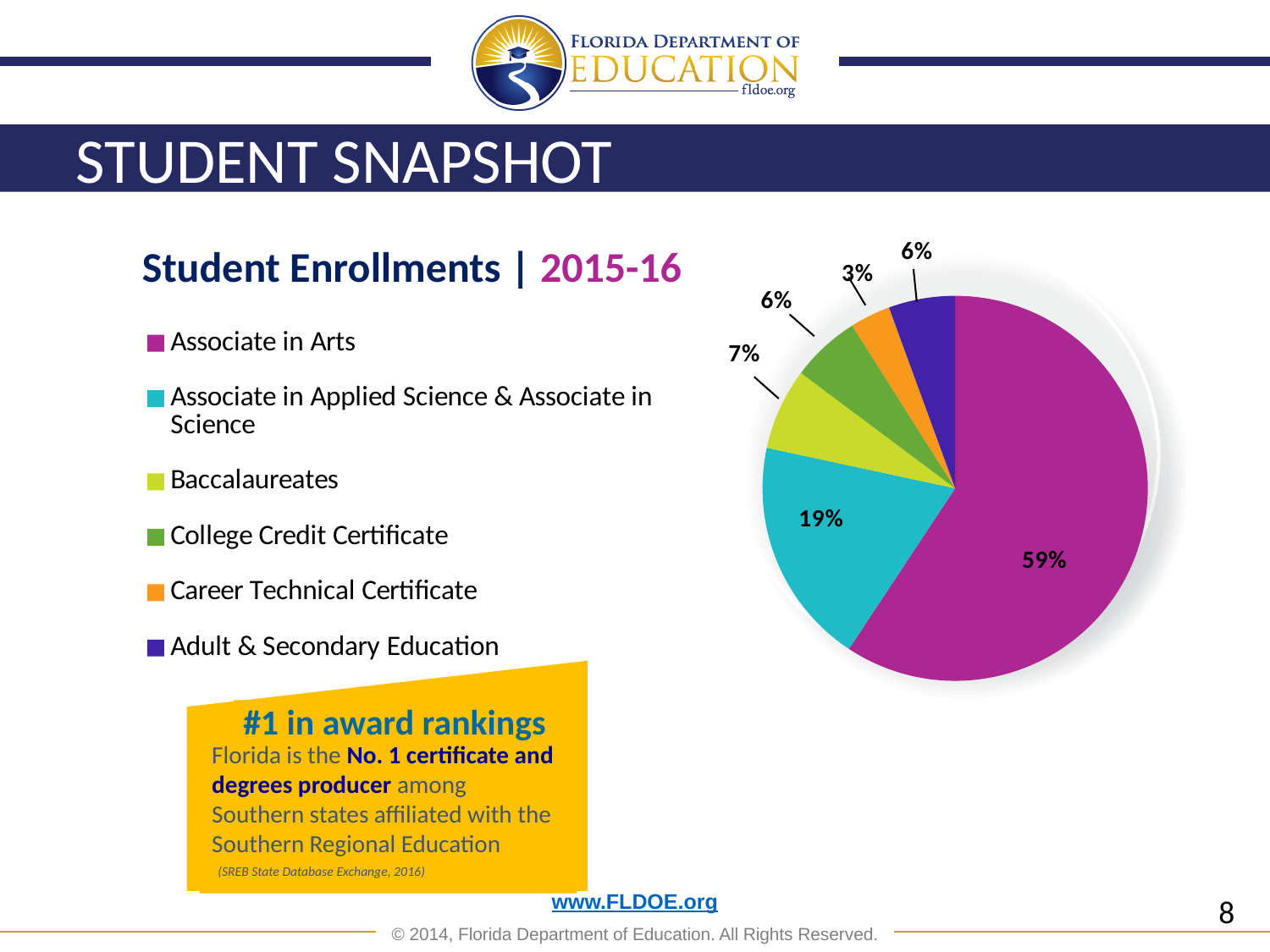
What share of student enrollments is Adult & Secondary Education? 6% What share of student enrollments is Career Technical Certificate? 3% Which category has the smallest share of the pie? Career Technical Certificate Which category has the largest share of the pie? Associate in Arts What share of student enrollments is Associate in Applied Science & Associate in Science? 19% Which is larger: Baccalaureates or College Credit Certificate? Baccalaureates How many categories does the pie chart legend list? 6 What share of student enrollments is Baccalaureates? 7% What is the title of the pie chart? Student Enrollments | 2015-16 What share of student enrollments is Associate in Arts? 59% What kind of chart is shown on the slide? pie chart What is the difference in percentage points between Associate in Arts and Associate in Applied Science & Associate in Science? 40